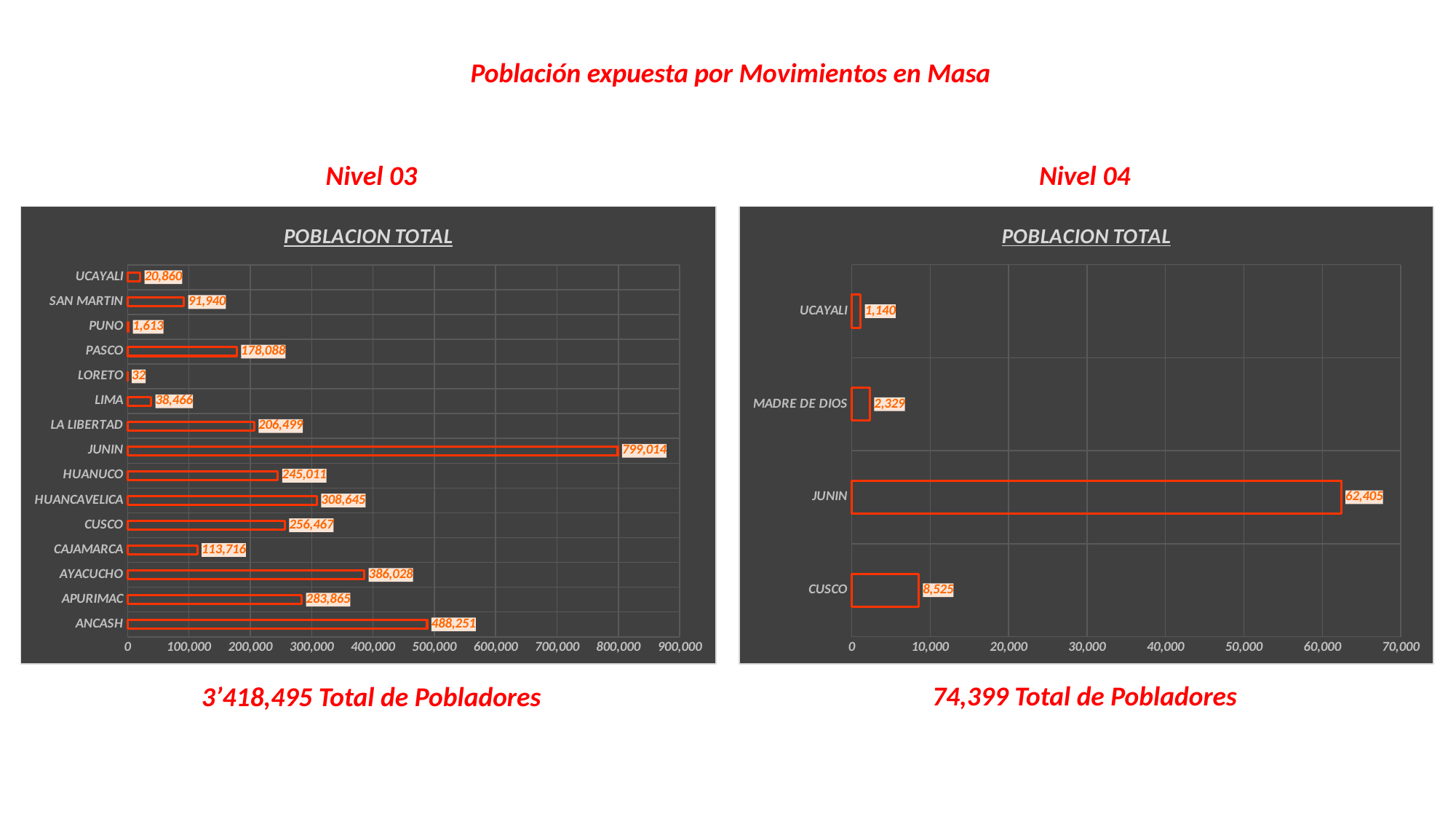
How many categories are shown in the Nivel 03 chart on the left? 15 What kind of chart is the Nivel 04 chart on the right? bar chart In the Nivel 04 chart on the right, what is the difference between the values for JUNIN and CUSCO? 53,880 In the Nivel 03 chart on the left, which category has the lowest value? LORETO In the Nivel 03 chart on the left, which is larger, the value for AYACUCHO or the value for HUANUCO? AYACUCHO In the Nivel 03 chart on the left, what is the value for HUANCAVELICA? 308,645 In the Nivel 03 chart on the left, what is the value for JUNIN? 799,014 In the Nivel 03 chart on the left, what is the difference between the values for JUNIN and ANCASH? 310,763 How many categories are shown in the Nivel 04 chart on the right? 4 In the Nivel 04 chart on the right, which category has the highest value? JUNIN In the Nivel 03 chart on the left, is the value for PASCO greater or less than 200,000? less In the Nivel 04 chart on the right, what is the value for MADRE DE DIOS? 2,329